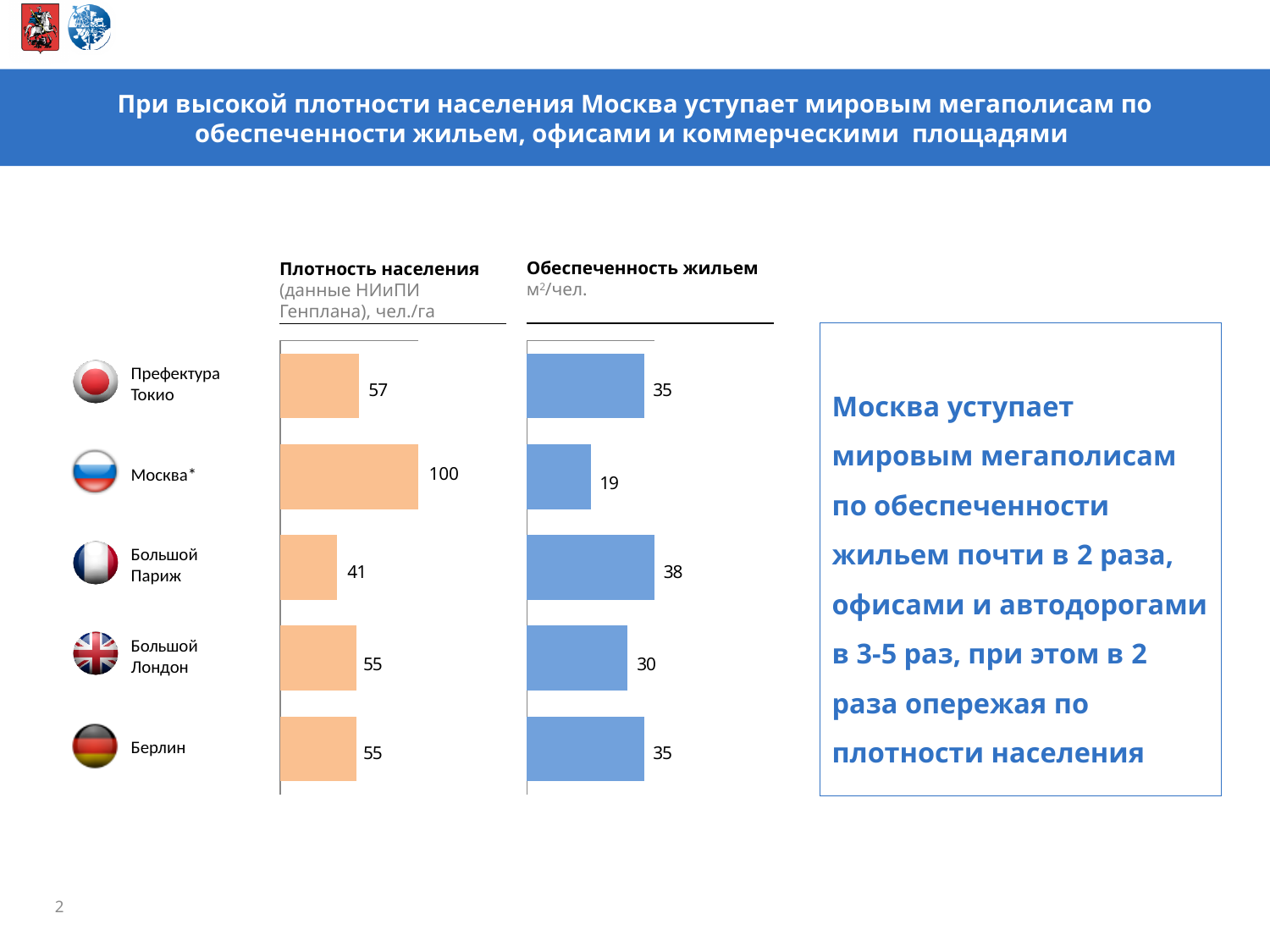
In the 'Обеспеченность жильем' chart, what is the value for Москва*? 19 In the 'Плотность населения' chart, what is the value for Москва*? 100 In the 'Плотность населения' chart, what is the difference between the values for Москва* and Префектура Токио? 43 How many cities are shown in the 'Плотность населения' chart? 5 In the 'Обеспеченность жильем' chart, what is the difference between the values for Большой Париж and Москва*? 19 In the 'Обеспеченность жильем' chart, what is the value for Большой Лондон? 30 In the 'Обеспеченность жильем' chart, which is larger: the value for Префектура Токио or the value for Большой Лондон? Префектура Токио In the 'Обеспеченность жильем' chart, which city has the lowest value? Москва* What type of chart is the 'Обеспеченность жильем' chart? Bar chart In the 'Плотность населения' chart, which city has the highest value? Москва* In the 'Плотность населения' chart, which city has the lowest value? Большой Париж In the 'Обеспеченность жильем' chart, which city has the highest value? Большой Париж